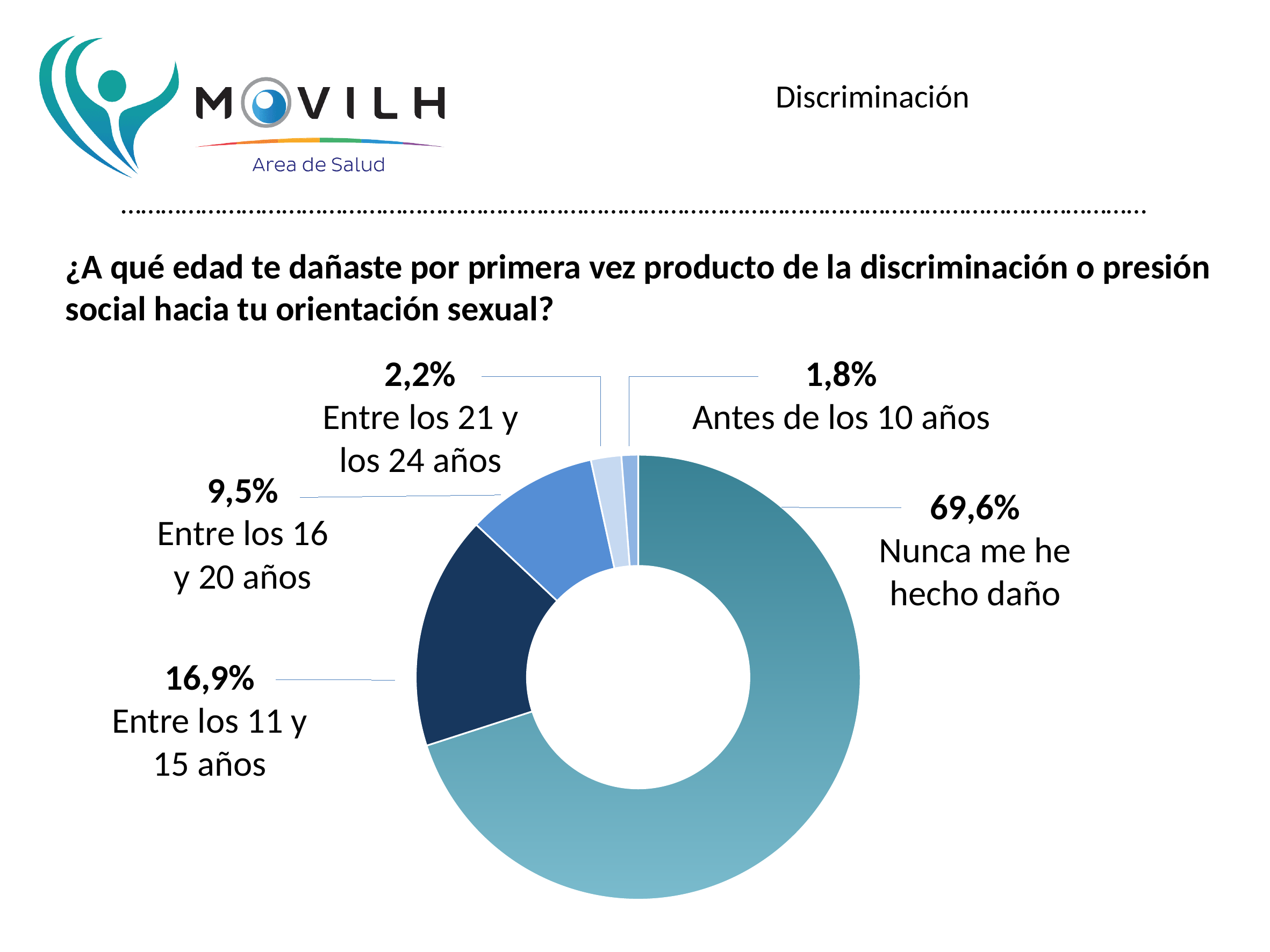
What percentage of respondents answered "Entre los 11 y 15 años"? 16,9% What percentage of respondents answered "Antes de los 10 años"? 1,8% What is the difference in percentage points between "Entre los 11 y 15 años" and "Entre los 16 y 20 años"? 7,4 Which is larger: the share for "Entre los 21 y los 24 años" or the share for "Antes de los 10 años"? Entre los 21 y los 24 años What kind of chart is shown on the slide? Doughnut chart What is the combined percentage of respondents who were harmed between the ages of 11 and 20 ("Entre los 11 y 15 años" plus "Entre los 16 y 20 años")? 26,4% What percentage of respondents answered "Entre los 16 y 20 años"? 9,5% What percentage of respondents answered "Entre los 21 y los 24 años"? 2,2% What percentage of respondents answered "Nunca me he hecho daño"? 69,6% Which category has the smallest share of the chart? Antes de los 10 años Which category has the largest share of the chart? Nunca me he hecho daño How many categories are shown in the chart? 5